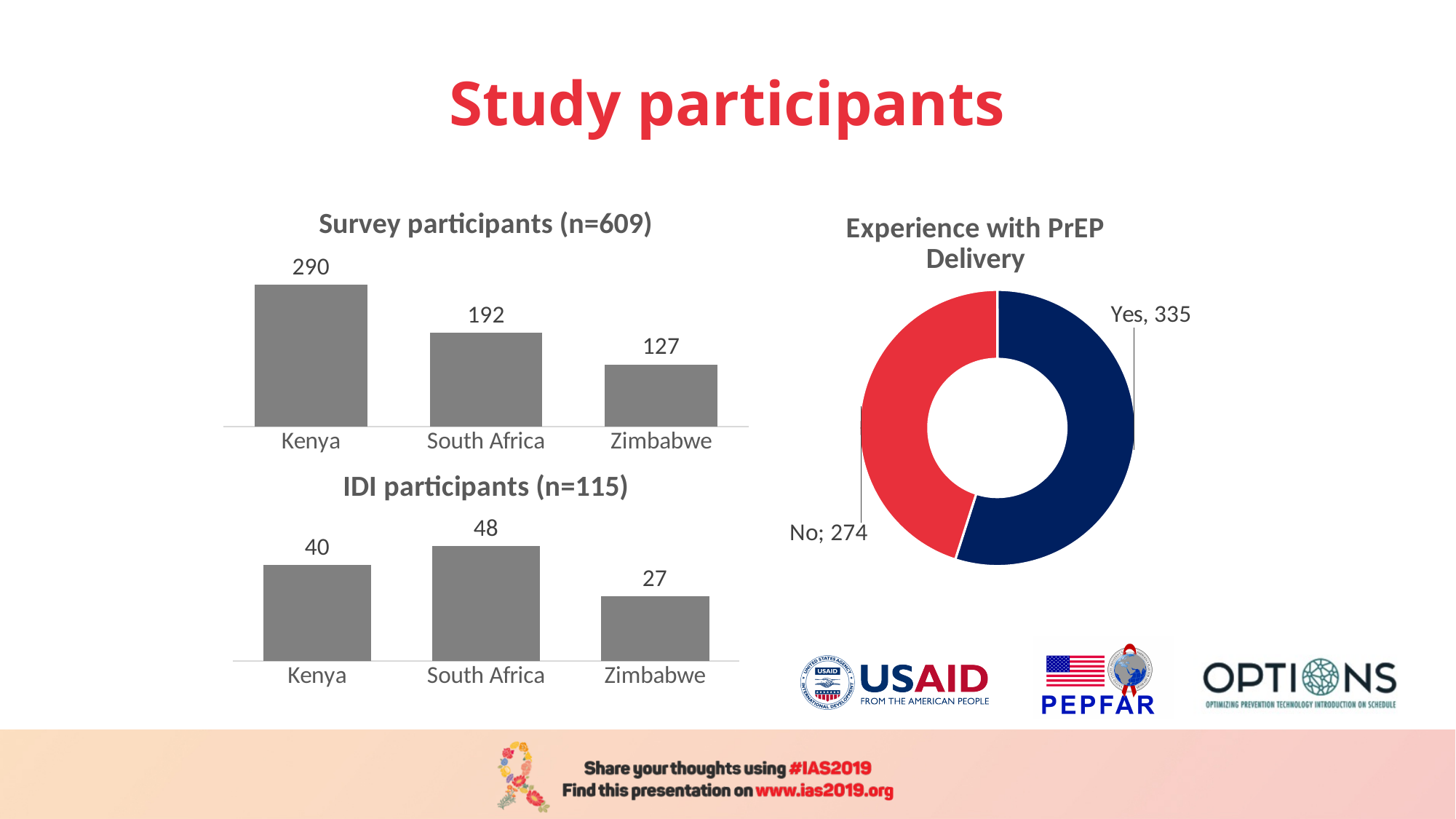
In the 'IDI participants (n=115)' chart, which country has the highest value? South Africa What kind of chart is the 'Experience with PrEP Delivery' chart? Doughnut chart In the 'Experience with PrEP Delivery' chart, what is the value for 'Yes'? 335 In the 'IDI participants (n=115)' chart, what is the value for South Africa? 48 In the 'Experience with PrEP Delivery' chart, what is the difference between 'Yes' and 'No'? 61 In the 'IDI participants (n=115)' chart, which is larger, Kenya or Zimbabwe? Kenya In the 'Survey participants (n=609)' chart, what is the value for Kenya? 290 In the 'Experience with PrEP Delivery' chart, what colour is the 'No' segment? Red In the 'Survey participants (n=609)' chart, which country has the lowest value? Zimbabwe How many countries are shown in the 'Survey participants (n=609)' chart? 3 In the 'Survey participants (n=609)' chart, what is the difference between Kenya and South Africa? 98 In the 'IDI participants (n=115)' chart, what is the difference between South Africa and Zimbabwe? 21